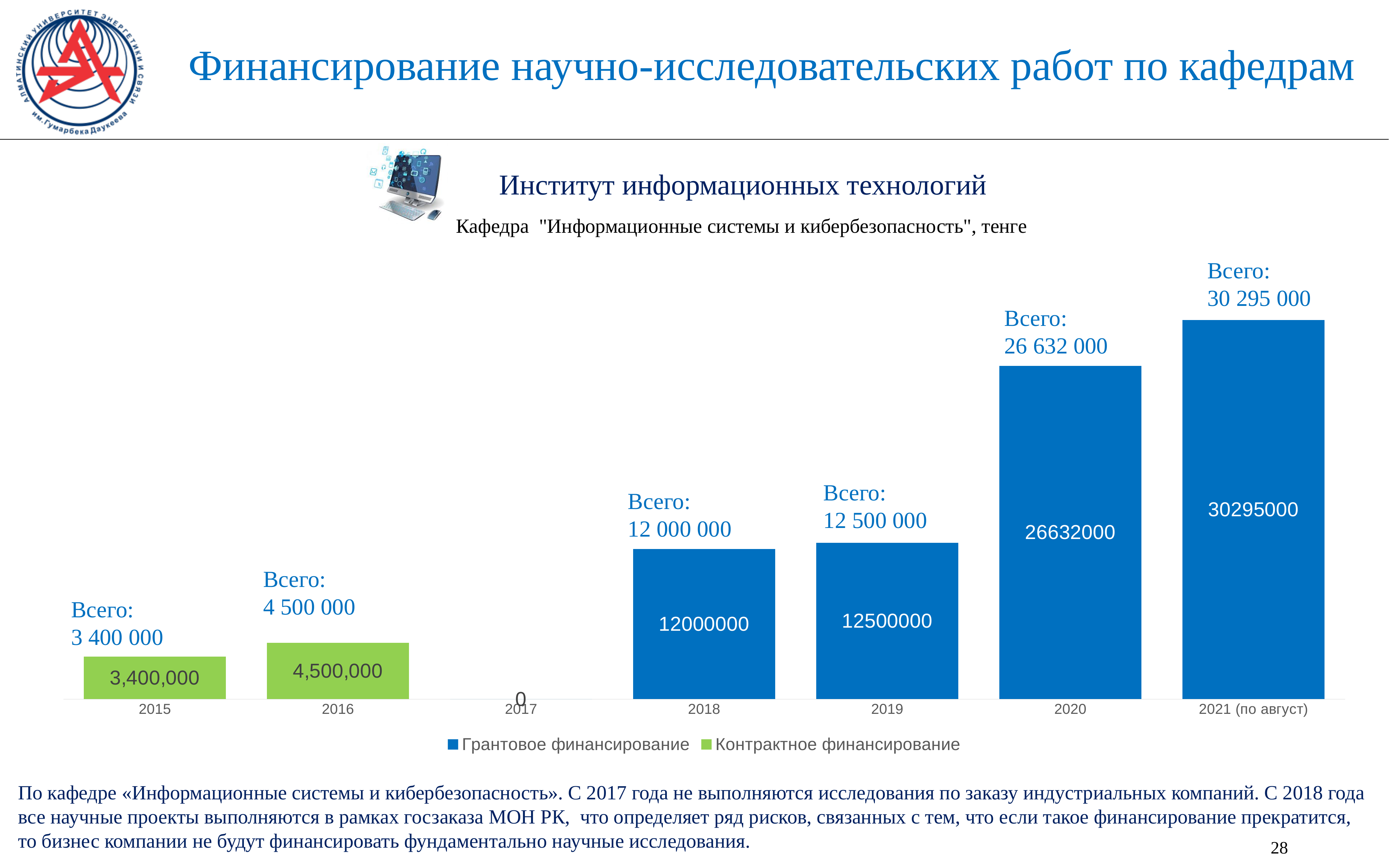
What is the total (Всего) shown for 2021 (по август)? 30 295 000 What is the value of grant funding (Грантовое финансирование) for 2018? 12000000 What type of chart is shown on the slide? bar chart What is the value of contract funding (Контрактное финансирование) for 2016? 4,500,000 How many series does the legend list? 2 What value is shown for 2017? 0 What is the difference between grant funding in 2019 and 2018? 500000 What is the value of grant funding (Грантовое финансирование) for 2020? 26632000 Which year has the highest funding? 2021 (по август) How many year categories are shown on the x axis? 7 Which is larger: the funding for 2020 or for 2019? 2020 What is the value of contract funding (Контрактное финансирование) for 2015? 3,400,000